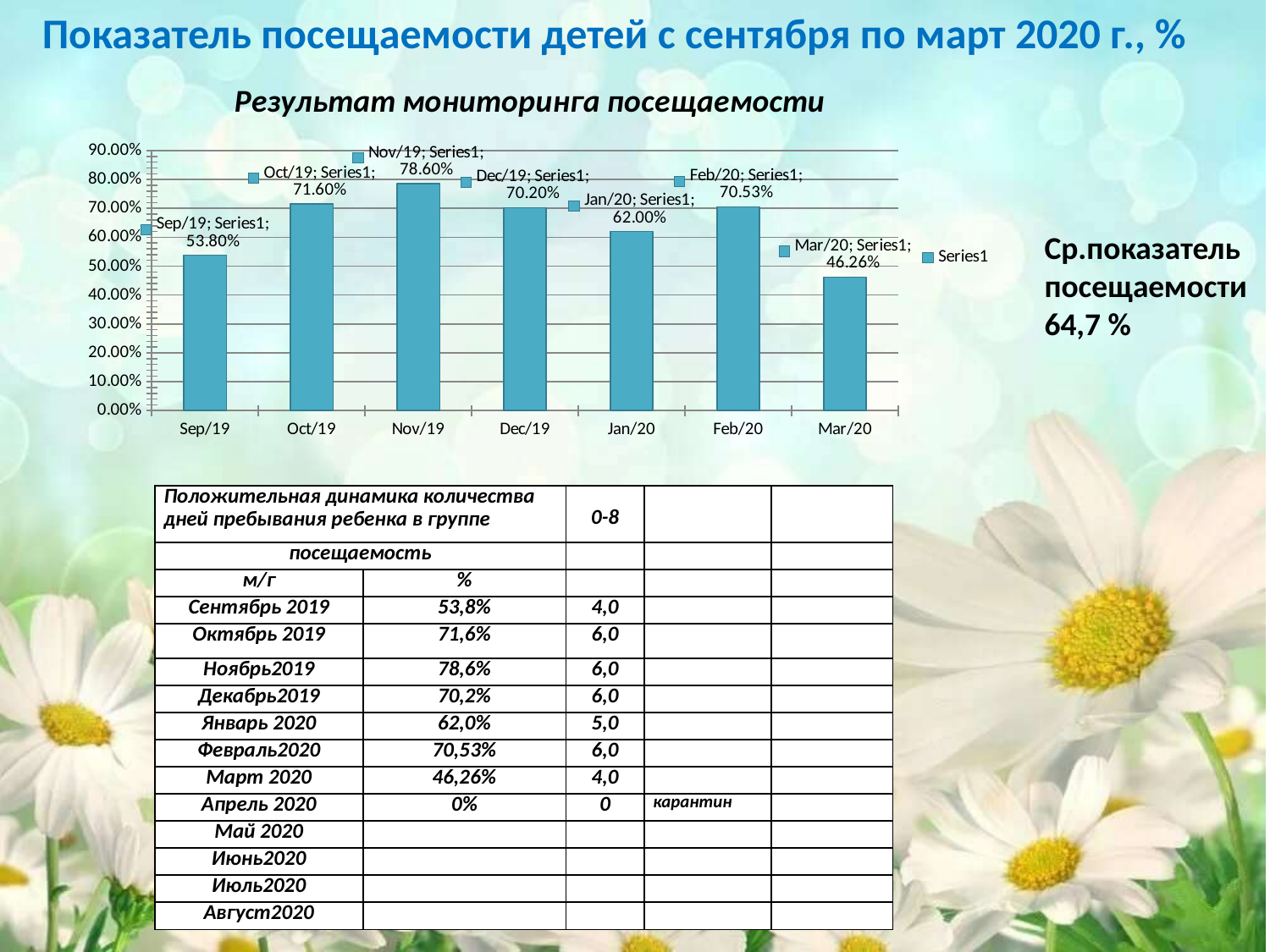
How many months are plotted in the chart? 7 Which month has the lowest value in the chart? Mar/20 What is the value for Nov/19 in the chart? 78.60% What is the title of the chart? Результат мониторинга посещаемости Is the value for Feb/20 greater or less than 60.00%? greater What is the value for Sep/19 in the chart? 53.80% Which month has the highest value in the chart? Nov/19 What kind of chart is shown on the slide? bar chart Which is larger, the value for Oct/19 or the value for Jan/20? Oct/19 How many series does the chart legend list? 1 What is the value for Mar/20 in the chart? 46.26% What is the difference between the values for Nov/19 and Mar/20? 32.34%